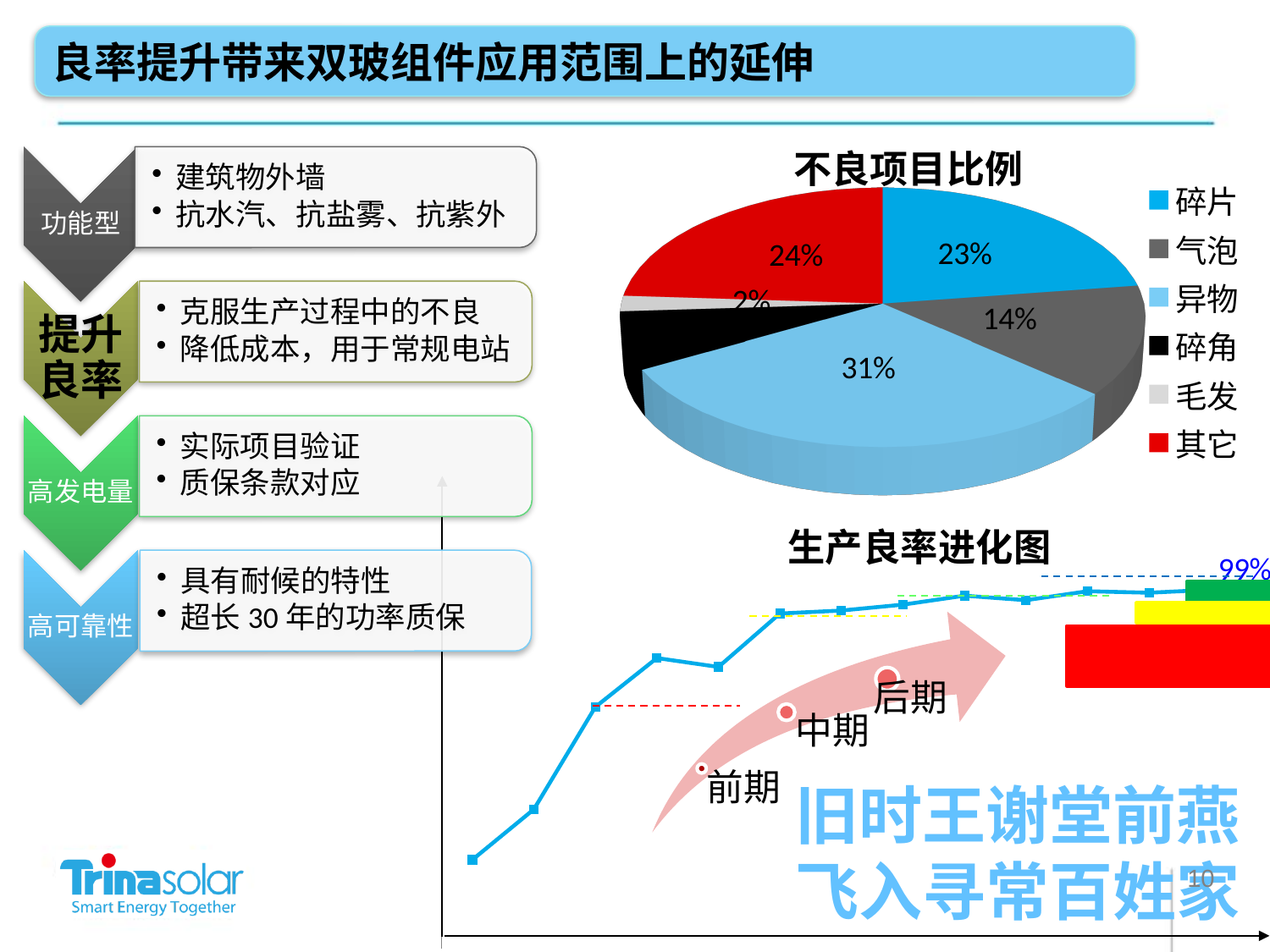
What kind of chart is the "不良项目比例" chart? pie chart In the "不良项目比例" pie chart, how many percentage points larger is 异物 than 气泡? 17 In the "不良项目比例" pie chart, what share does 气泡 have? 14% In the "不良项目比例" pie chart, which is larger, 碎片 or 气泡? 碎片 How many entries does the legend of the "不良项目比例" pie chart list? 6 What kind of chart is the "生产良率进化图" chart? line chart In the "不良项目比例" pie chart, what share does 异物 have? 31% In the "不良项目比例" pie chart, which category has the largest share? 异物 In the "不良项目比例" pie chart, what share does 碎片 have? 23% In the "不良项目比例" pie chart, what share does 其它 have? 24% In the "生产良率进化图" chart, do the values generally rise or fall along the x axis? rise In the "生产良率进化图" chart, what percentage is annotated at the top right of the line? 99%